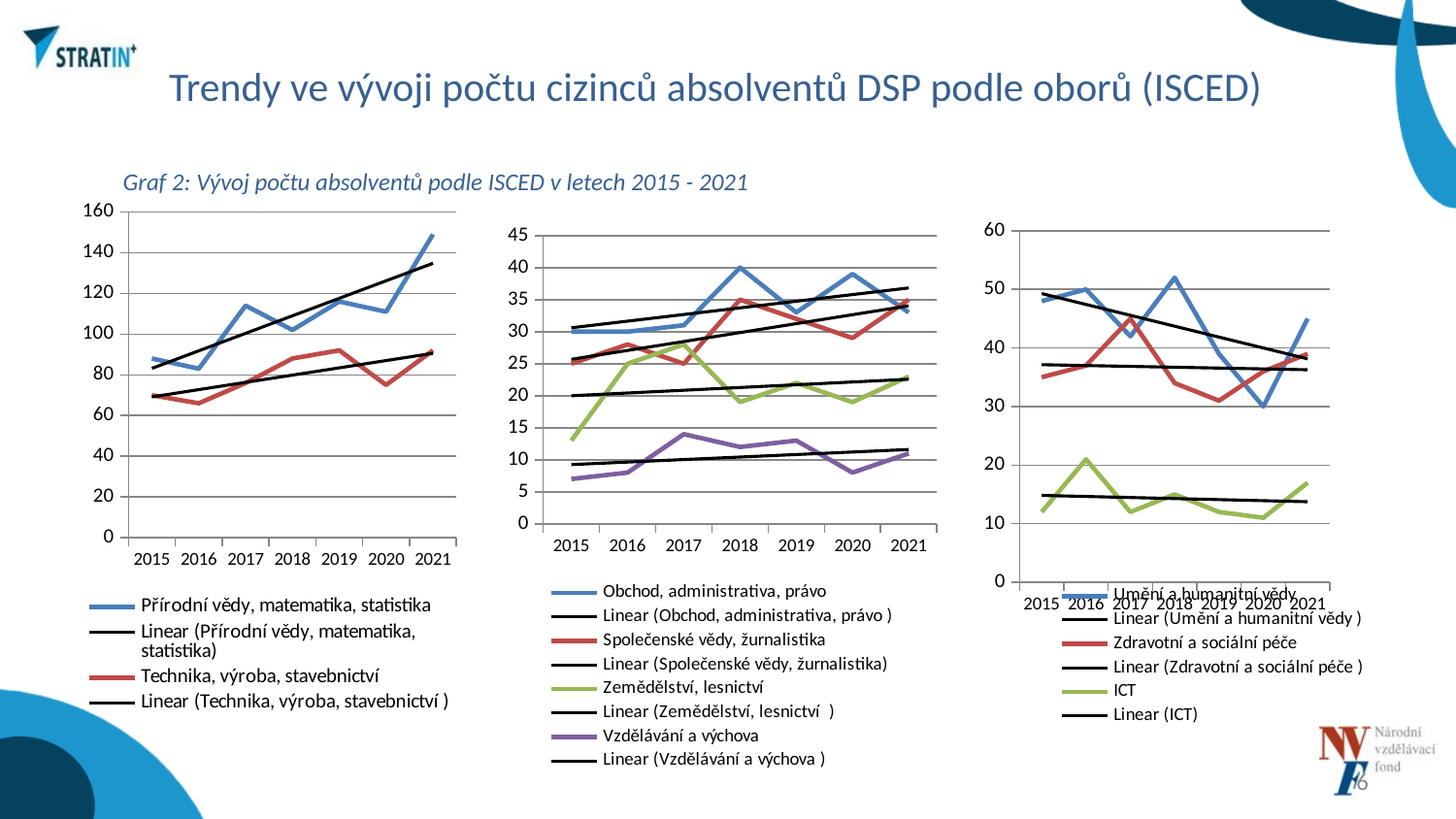
In the left chart (y-axis up to 160), in which year is Přírodní vědy, matematika, statistika highest? 2021 In the middle chart (y-axis up to 45), in which year is Zemědělství, lesnictví lowest? 2015 In the right chart (y-axis up to 60), is the value for Umění a humanitní vědy in 2020 greater or less than 40? less In the middle chart (y-axis up to 45), how many entries does the legend list? 8 In the middle chart (y-axis up to 45), is the value for Obchod, administrativa, právo in 2018 greater or less than 35? greater In the left chart (y-axis up to 160), which series has the higher value in 2017: Přírodní vědy, matematika, statistika or Technika, výroba, stavebnictví? Přírodní vědy, matematika, statistika In the right chart (y-axis up to 60), in which year is ICT highest? 2016 In the left chart (y-axis up to 160), is the value for Přírodní vědy, matematika, statistika in 2021 greater or less than 140? greater In the left chart (y-axis up to 160), how many entries does the legend list? 4 What kind of chart is the left chart (with the y-axis up to 160)? line chart In the left chart (y-axis up to 160), how many years are shown on the x axis? 7